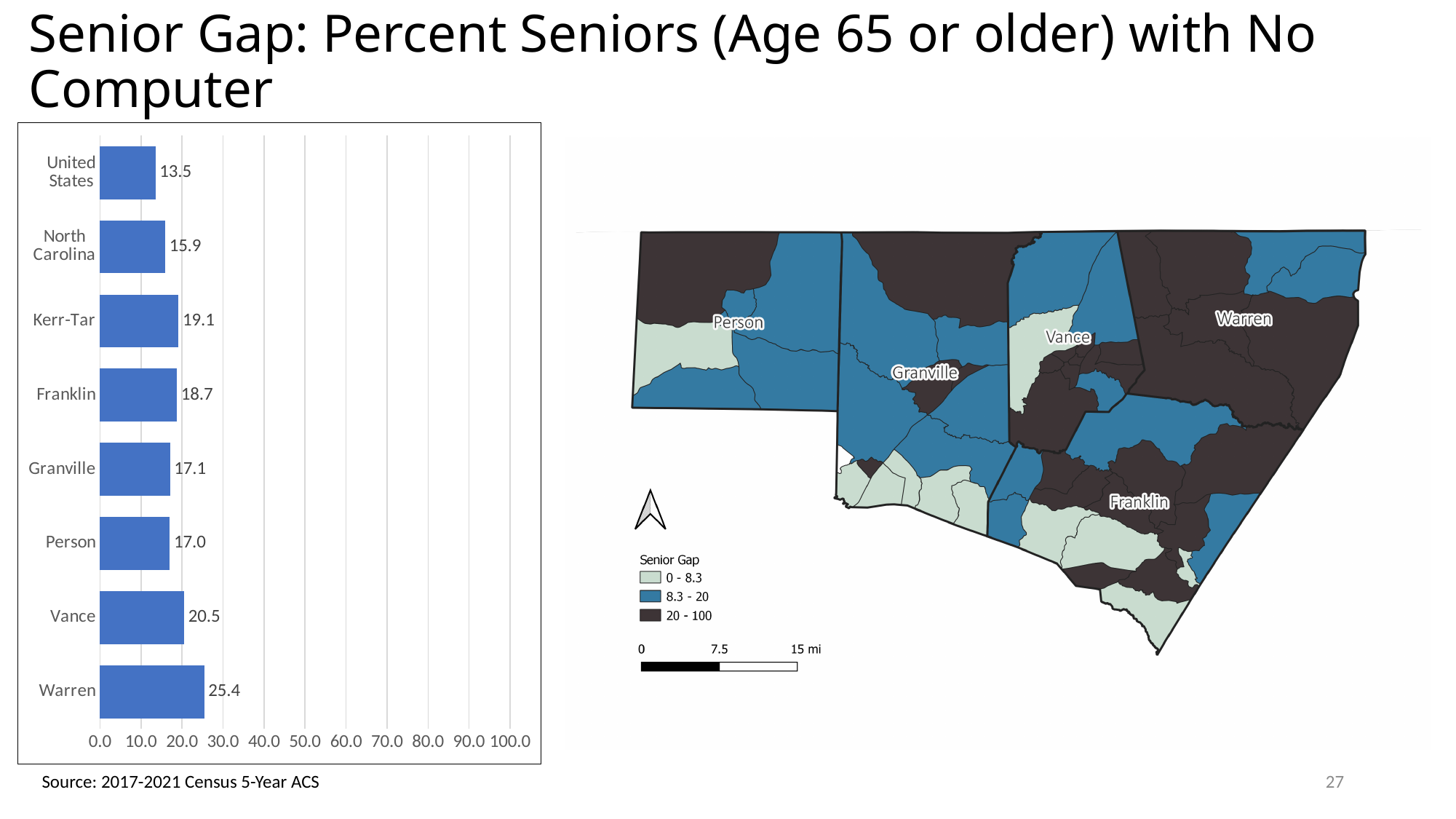
What is the value for Kerr-Tar in the bar chart? 19.1 What is the highest value shown on the x axis of the bar chart? 100.0 What is the difference between the values for Warren and Vance in the bar chart? 4.9 What kind of chart is shown on the left of the slide? bar chart How many categories are shown in the bar chart? 8 Which category has the highest value in the bar chart? Warren What is the value for the United States in the bar chart? 13.5 In the bar chart, which is larger, the value for Vance or the value for Franklin? Vance What is the value for Warren in the bar chart? 25.4 Which category has the lowest value in the bar chart? United States Is the value for Warren in the bar chart greater or less than 20.0? greater What is the difference between the values for Kerr-Tar and North Carolina in the bar chart? 3.2